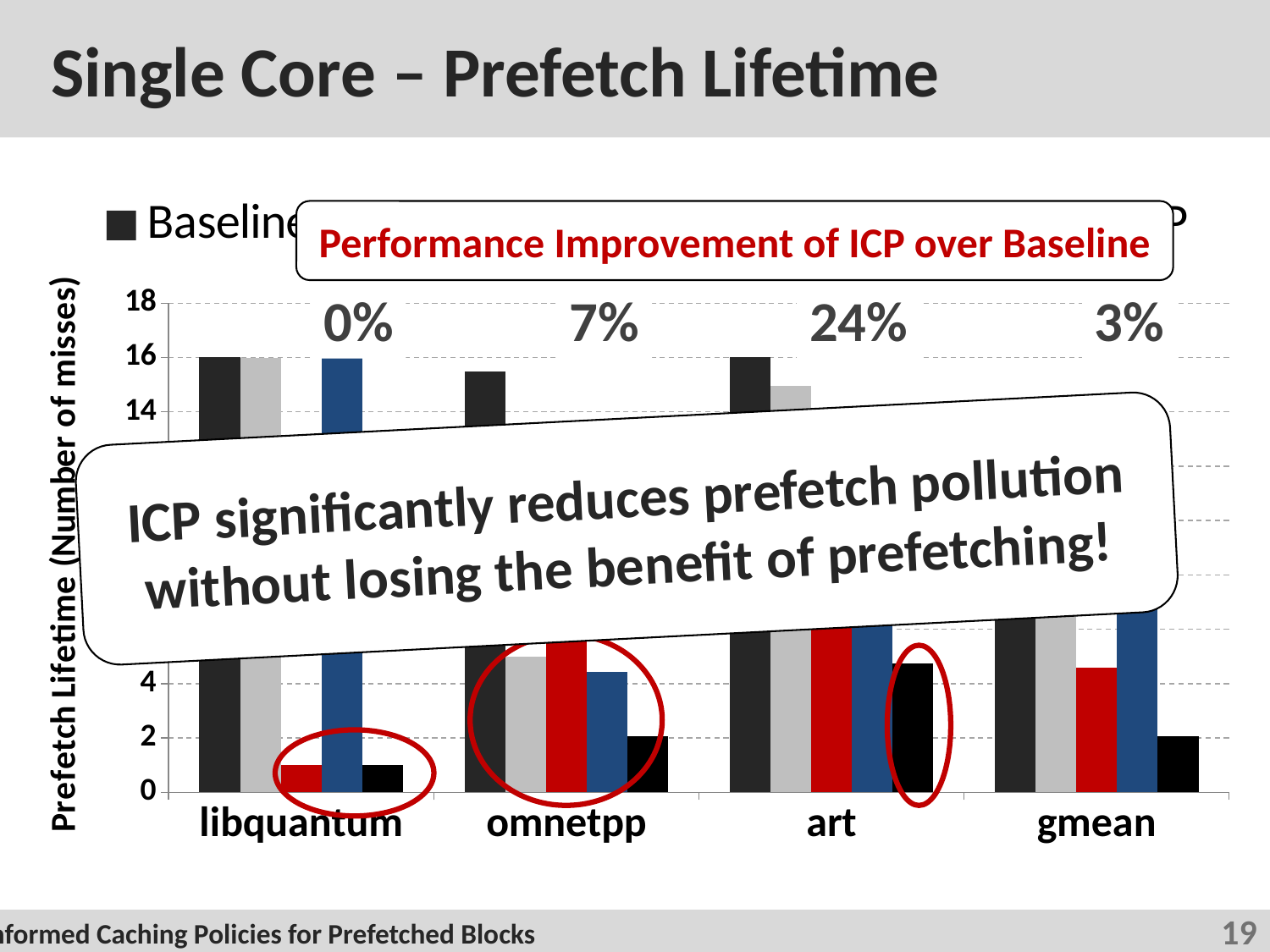
Is the value of the red bar for libquantum greater or less than 2? less How many categories are shown on the x axis of the chart? 4 Is the Baseline value for libquantum greater or less than 14? greater What is the title of the y axis of the chart? Prefetch Lifetime (Number of misses) For libquantum, which is larger: the Baseline bar or the red bar? Baseline What kind of chart is shown on the slide? bar chart Is the value of the red bar for omnetpp greater or less than 4? greater Which is larger: the black (rightmost) bar for art or the black (rightmost) bar for libquantum? art What performance improvement of ICP over Baseline is shown above the art category? 24%